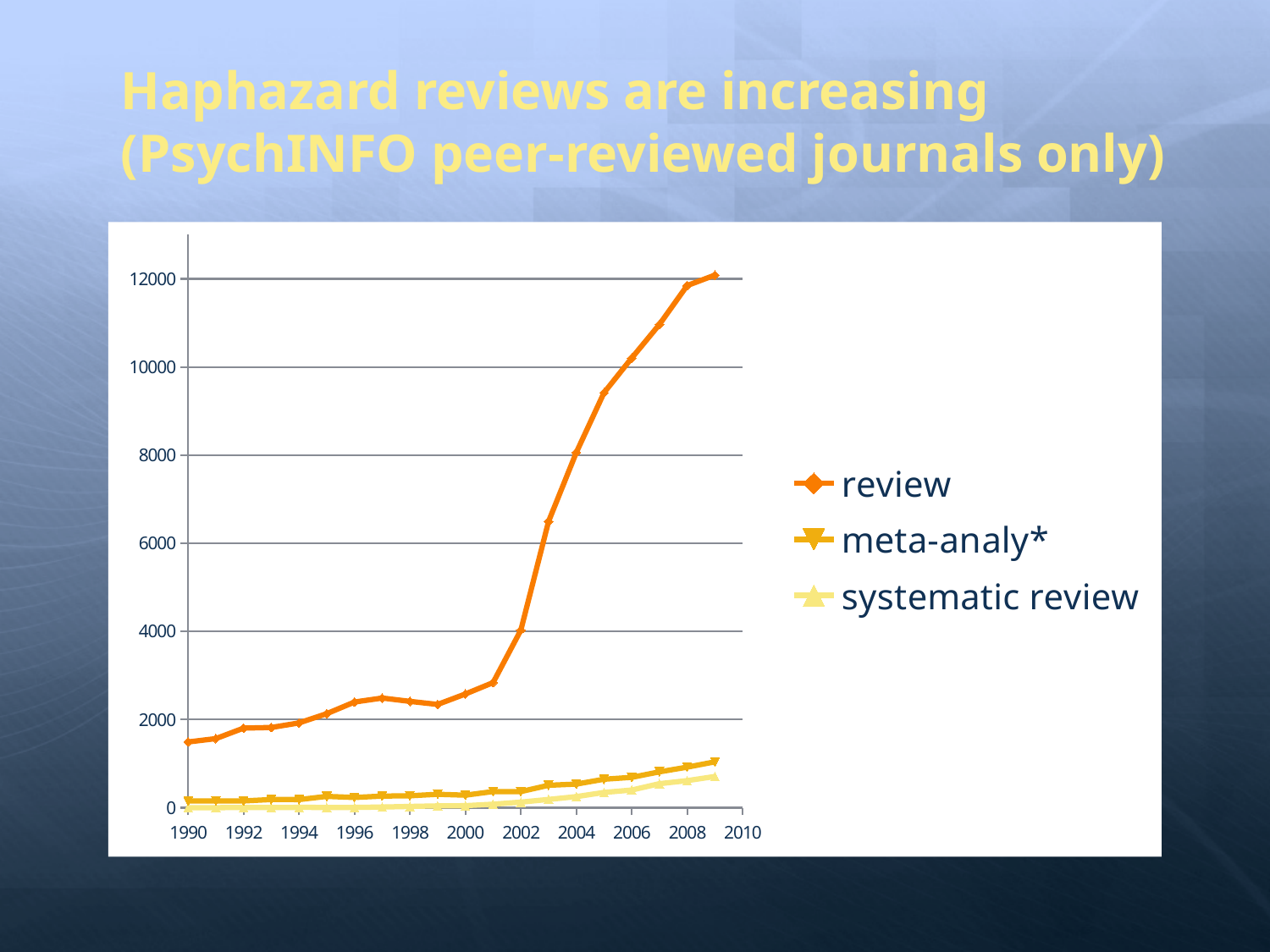
How many series does the legend list? 3 Does the review series rise or fall from 1990 to 2009? rise Is the value for review in 1990 greater or less than 2000? less What is the title of the slide containing the chart? Haphazard reviews are increasing (PsychINFO peer-reviewed journals only) In 2009, which is larger: the value for meta-analy* or the value for systematic review? meta-analy* What kind of chart is shown on the slide? line chart Is the value for review in 2005 greater or less than 8000? greater Is the value for meta-analy* in 2009 greater or less than 2000? less Which series has the lowest values across the chart? systematic review Which series reaches the highest value on the chart? review In 2009, which is larger: the value for review or the value for meta-analy*? review